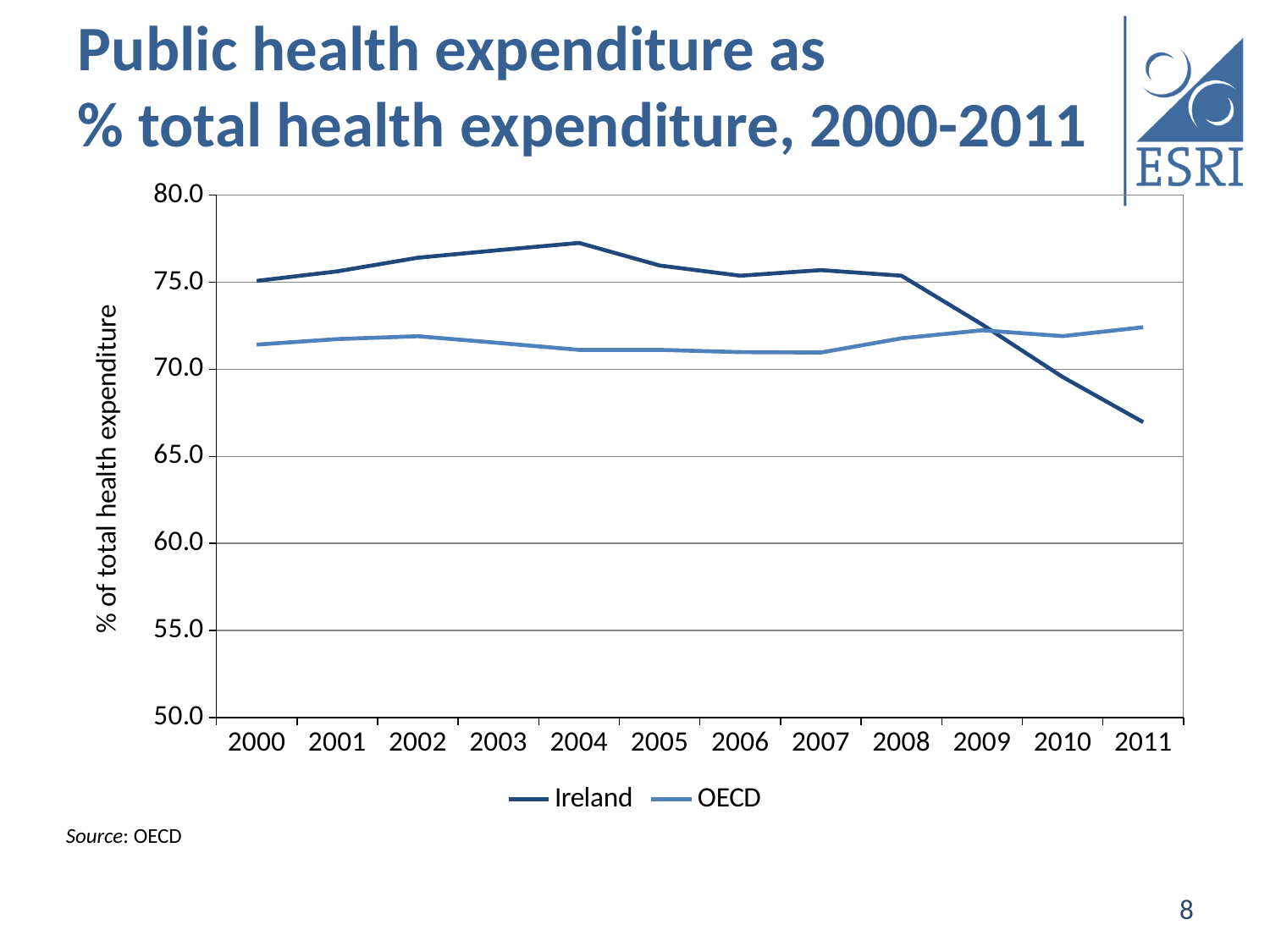
Does the Ireland line rise or fall between 2008 and 2011? Fall Which series has the higher value in 2011, Ireland or OECD? OECD Is the value for OECD in 2006 greater or less than 75.0? less In which year does the Ireland line reach its lowest value? 2011 Which series has the higher value in 2004, Ireland or OECD? Ireland How many series does the legend list? 2 In which year does the Ireland line reach its highest value? 2004 How many years are plotted along the x axis? 12 What is the label on the y axis of the chart? % of total health expenditure Is the value for Ireland in 2011 greater or less than 70.0? less Is the value for Ireland in 2004 greater or less than 75.0? greater What kind of chart is shown on the slide? Line chart